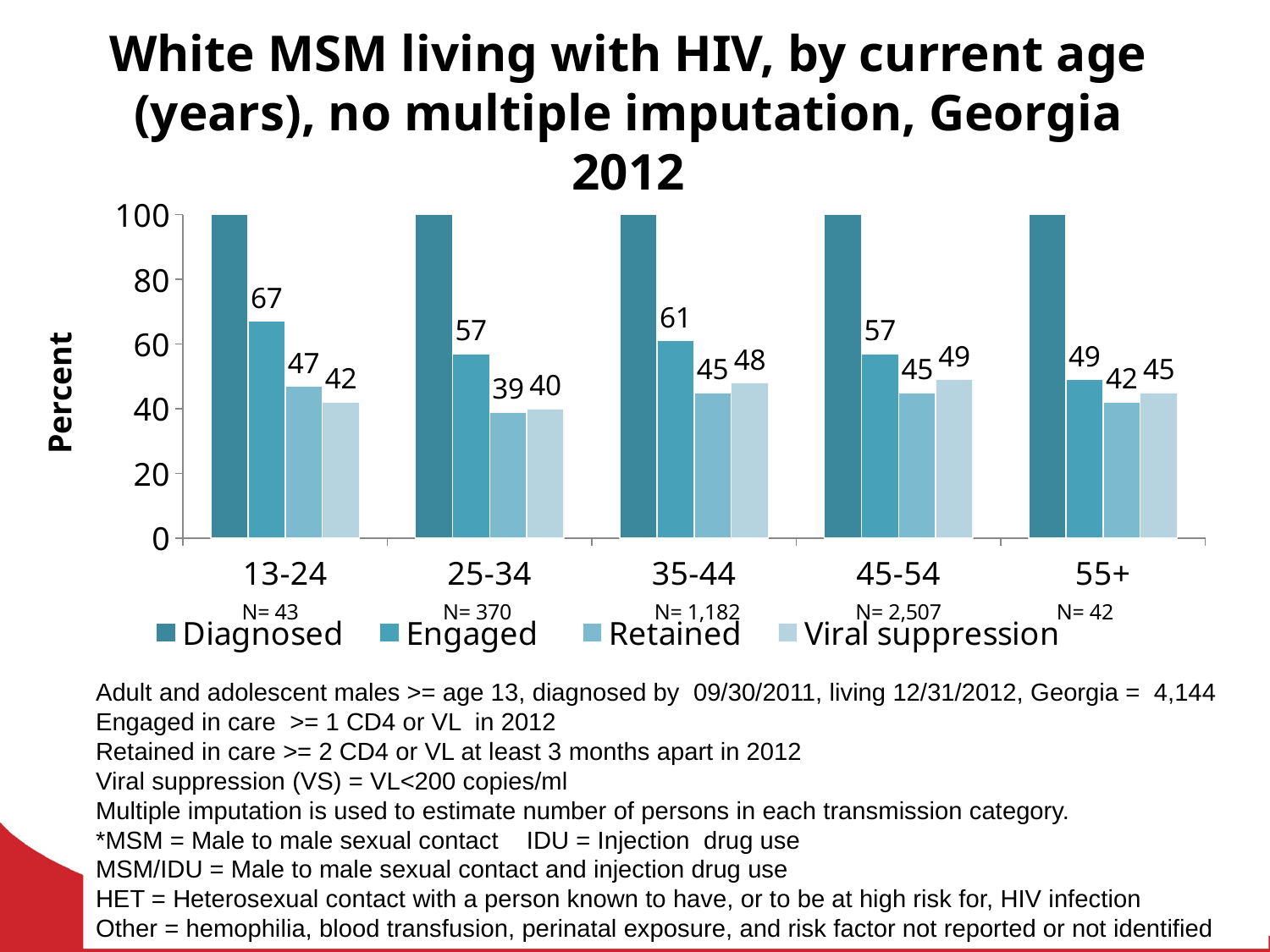
What is the Retained value for the 25-34 age group? 39 What is the label on the y axis? Percent What is the Engaged value for the 13-24 age group? 67 How many age groups are shown on the x axis? 5 What kind of chart is shown on the slide? bar chart Is the Engaged value for the 25-34 age group greater or less than 40? greater Which age group has the highest Engaged value? 13-24 Which is larger for the 55+ age group, the Retained value or the Viral suppression value? Viral suppression Which age group has the lowest Retained value? 25-34 How many series does the legend list? 4 What is the difference between the Engaged and Retained values for the 35-44 age group? 16 What is the Viral suppression value for the 45-54 age group? 49